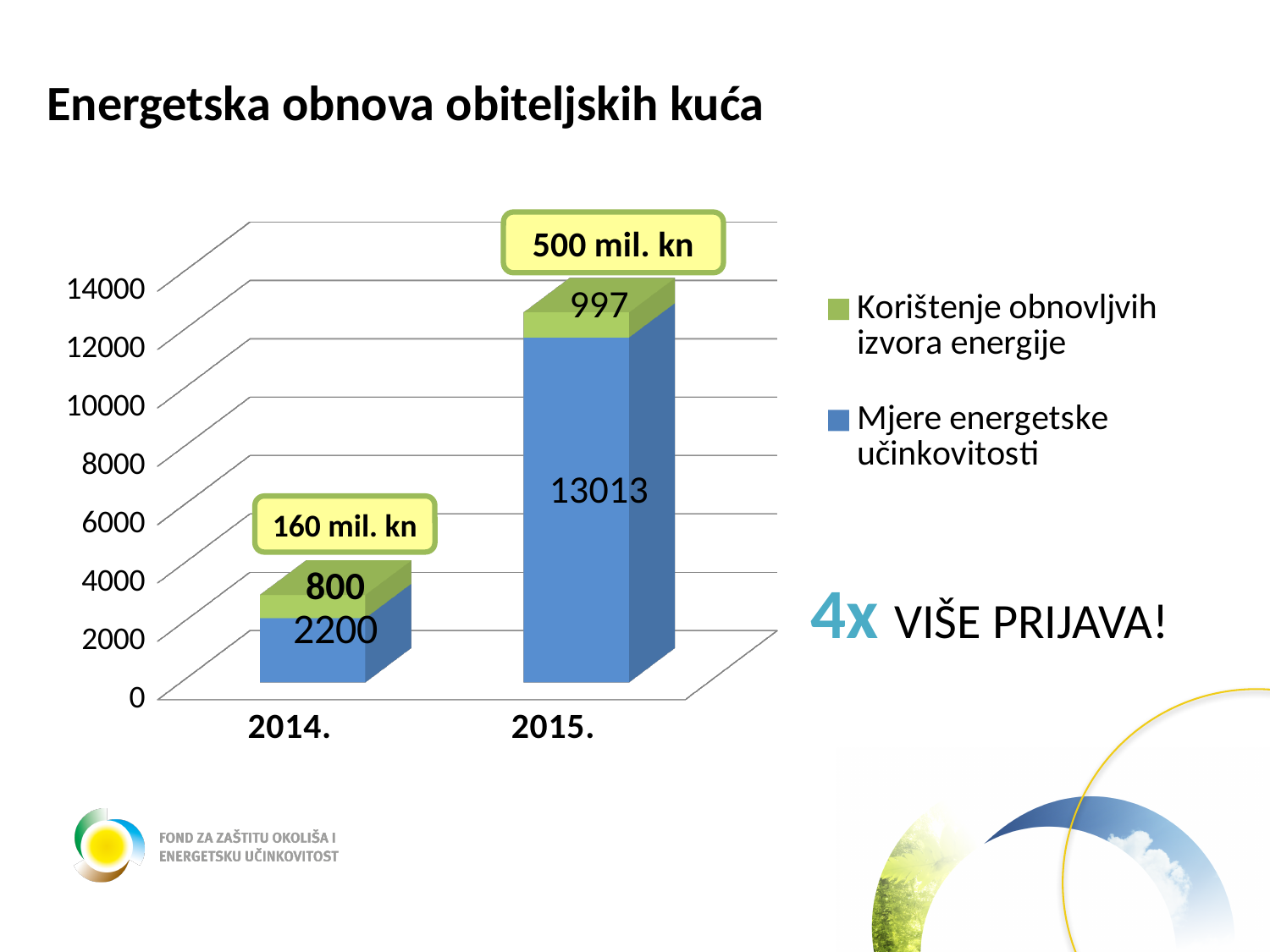
How many years are shown on the x axis? 2 What is the total of the stacked bar for 2015.? 14010 What is the value for Korištenje obnovljivih izvora energije in 2014.? 800 What is the value for Mjere energetske učinkovitosti in 2015.? 13013 What is the value for Mjere energetske učinkovitosti in 2014.? 2200 Is the value for Korištenje obnovljivih izvora energije in 2015. larger or smaller than in 2014.? larger What kind of chart is shown on the slide? stacked bar chart Which year has the higher value for Mjere energetske učinkovitosti? 2015. How many series does the legend list? 2 What is the value for Korištenje obnovljivih izvora energije in 2015.? 997 What is the difference between the Mjere energetske učinkovitosti values for 2015. and 2014.? 10813 What is the total of the stacked bar for 2014.? 3000